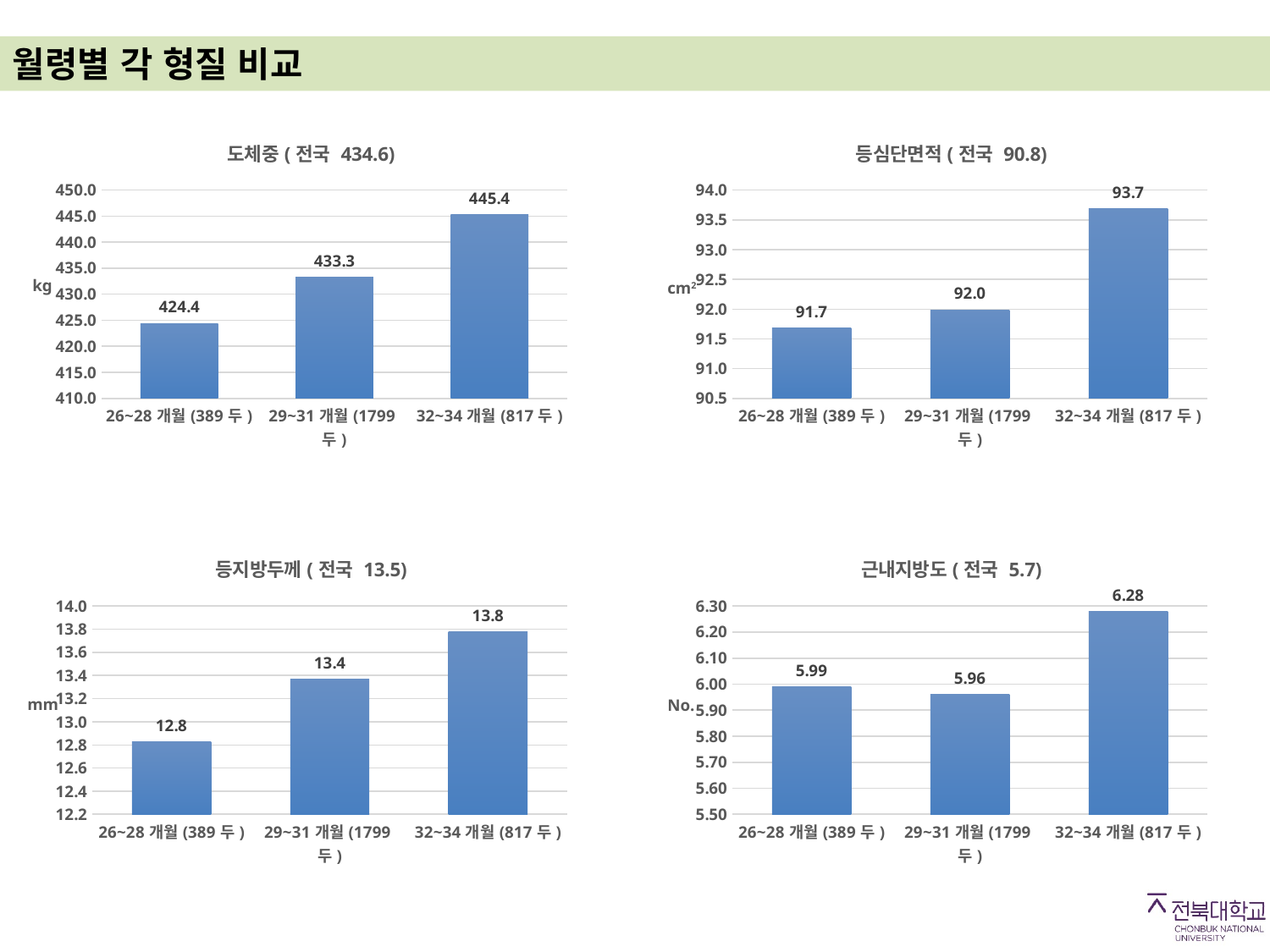
In the 도체중 chart (top left), what is the difference between the values for 32~34 개월 (817 두) and 26~28 개월 (389 두)? 21.0 In the 등심단면적 chart (top right), what is the value for 26~28 개월 (389 두)? 91.7 In the 도체중 chart (top left), which category has the highest value? 32~34 개월 (817 두) How many categories are shown in the 등심단면적 chart (top right)? 3 In the 근내지방도 chart (bottom right), which category has the lowest value? 29~31 개월 (1799 두) What kind of chart is the 도체중 chart (top left)? bar chart In the 등지방두께 chart (bottom left), is the value for 26~28 개월 (389 두) greater or less than 13.0? less In the 도체중 chart (top left), what is the value for 32~34 개월 (817 두)? 445.4 In the 등심단면적 chart (top right), what is the difference between the values for 32~34 개월 (817 두) and 29~31 개월 (1799 두)? 1.7 In the 등지방두께 chart (bottom left), what is the value for 29~31 개월 (1799 두)? 13.4 In the 근내지방도 chart (bottom right), which is larger: the value for 26~28 개월 (389 두) or 32~34 개월 (817 두)? 32~34 개월 (817 두) In the 등지방두께 chart (bottom left), do the values rise or fall from left to right? rise